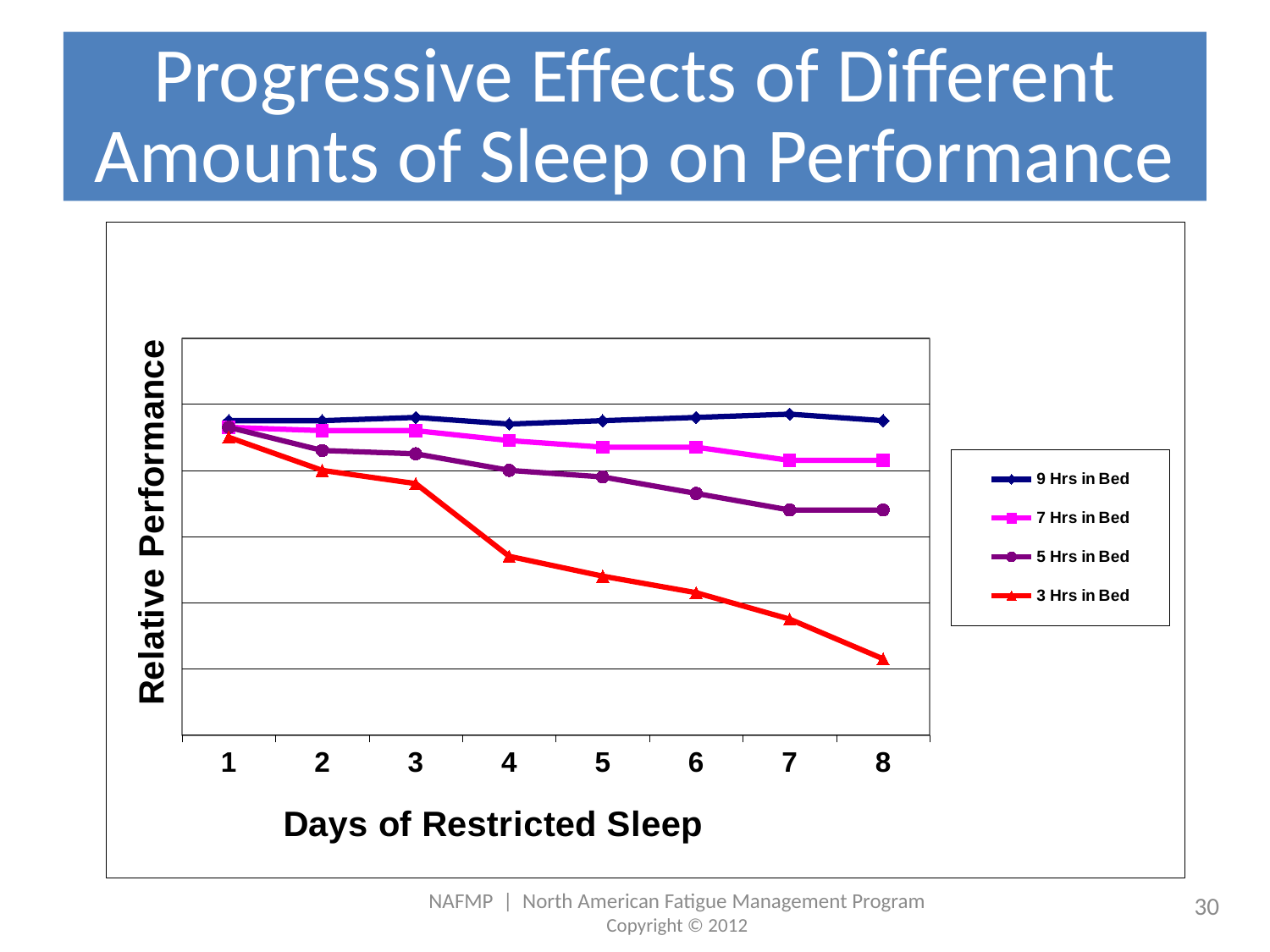
On day 8, which series has higher relative performance: 7 Hrs in Bed or 5 Hrs in Bed? 7 Hrs in Bed Which series has the lowest relative performance on day 8? 3 Hrs in Bed How many series does the legend list? 4 How many days are shown along the x axis? 8 Which series shows the steepest decline in relative performance over the 8 days? 3 Hrs in Bed Which series has the highest relative performance on day 8? 9 Hrs in Bed Does the relative performance for 5 Hrs in Bed rise or fall across the days of restricted sleep? fall On day 4, which series has higher relative performance: 5 Hrs in Bed or 3 Hrs in Bed? 5 Hrs in Bed What is the label of the x axis? Days of Restricted Sleep What is the label of the y axis? Relative Performance What kind of chart is shown on the slide? line chart Does the relative performance for 3 Hrs in Bed rise or fall as the days of restricted sleep increase? fall